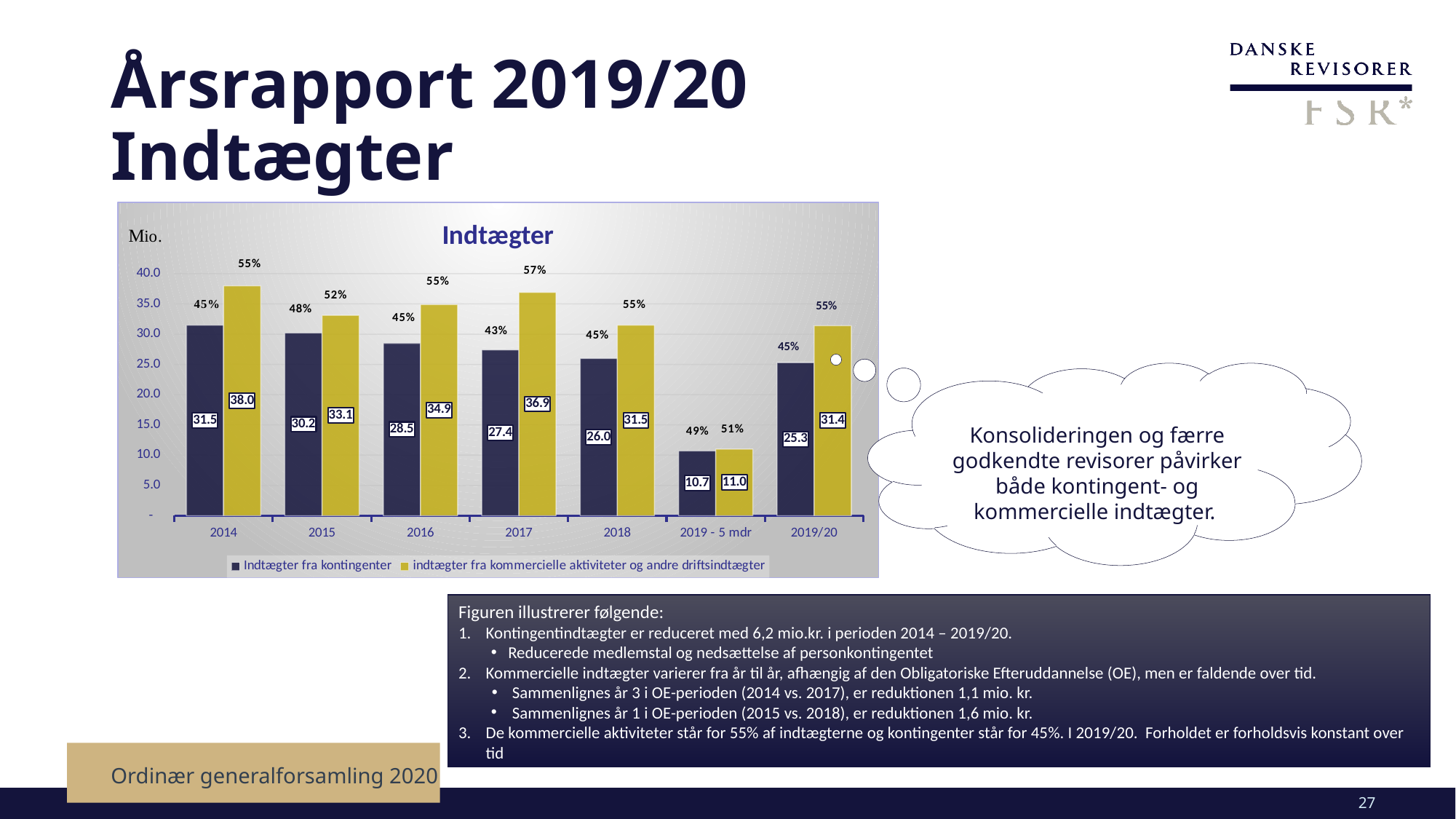
Which year has the highest value for 'indtægter fra kommercielle aktiviteter og andre driftsindtægter'? 2014 What is the difference between 'Indtægter fra kontingenter' in 2014 and in 2019/20? 6.2 What is the title of the chart? Indtægter Which is larger in 2018: 'Indtægter fra kontingenter' or 'indtægter fra kommercielle aktiviteter og andre driftsindtægter'? indtægter fra kommercielle aktiviteter og andre driftsindtægter What is the value of 'Indtægter fra kontingenter' for 2014? 31.5 What type of chart is shown on the slide? bar chart Which category has the lowest value for 'Indtægter fra kontingenter'? 2019 - 5 mdr How many series does the legend list? 2 What is the value of 'indtægter fra kommercielle aktiviteter og andre driftsindtægter' for 2017? 36.9 Does 'Indtægter fra kontingenter' rise or fall from 2014 to 2018? fall How many categories are shown on the x axis? 7 What is the value of 'Indtægter fra kontingenter' for 2019/20? 25.3